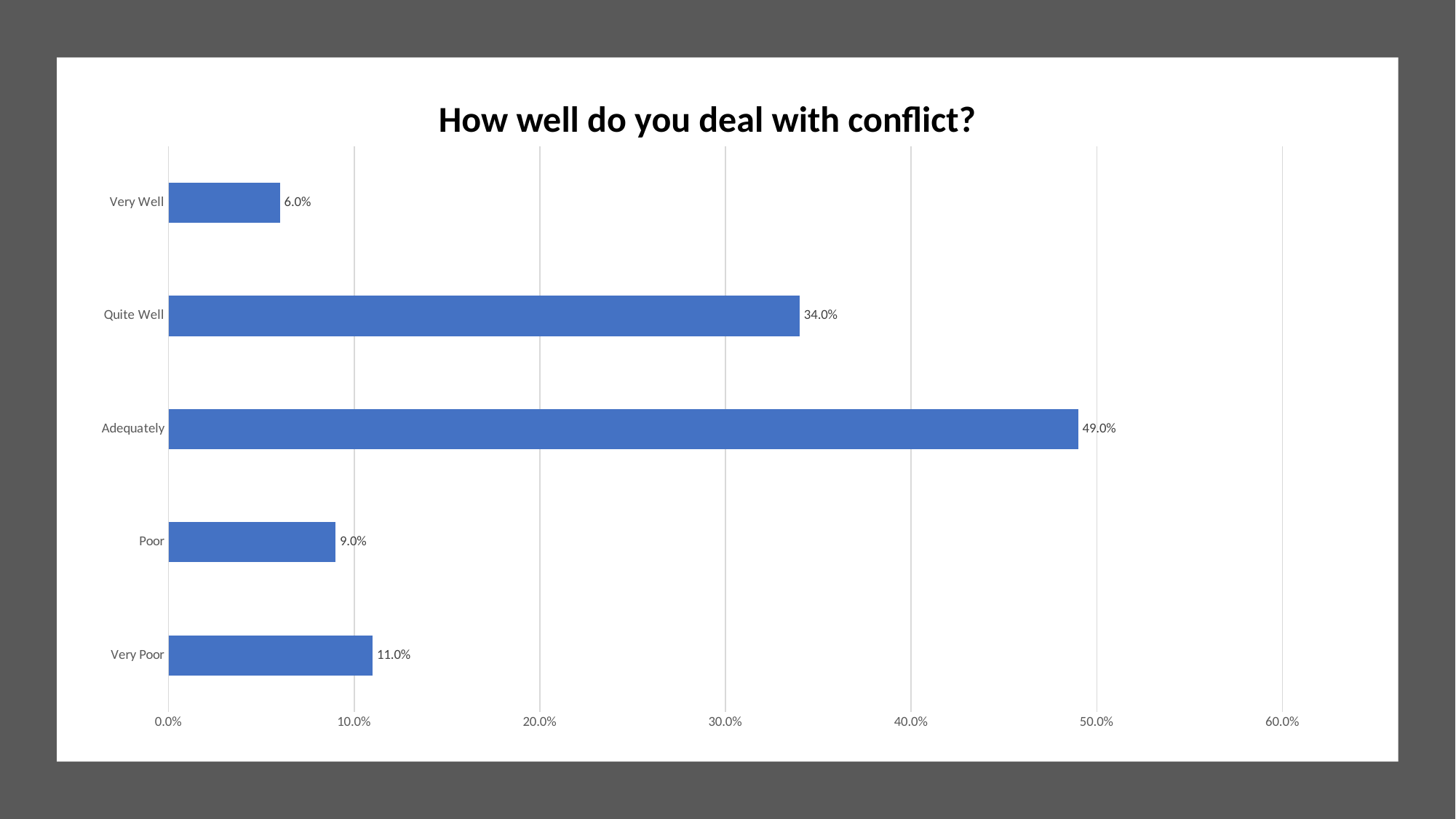
What kind of chart is shown on the slide? Bar chart Is the value for Quite Well greater or less than 30.0%? greater Which category has the lowest value? Very Well Which is larger, the value for Poor or the value for Very Well? Poor What is the value for Very Poor? 11.0% What is the title of the chart? How well do you deal with conflict? What is the value for Quite Well? 34.0% What is the difference between the values for Very Poor and Poor? 2.0% What is the value for Adequately? 49.0% How many categories are shown in the chart? 5 What is the difference between the values for Adequately and Quite Well? 15.0% Which category has the highest value? Adequately